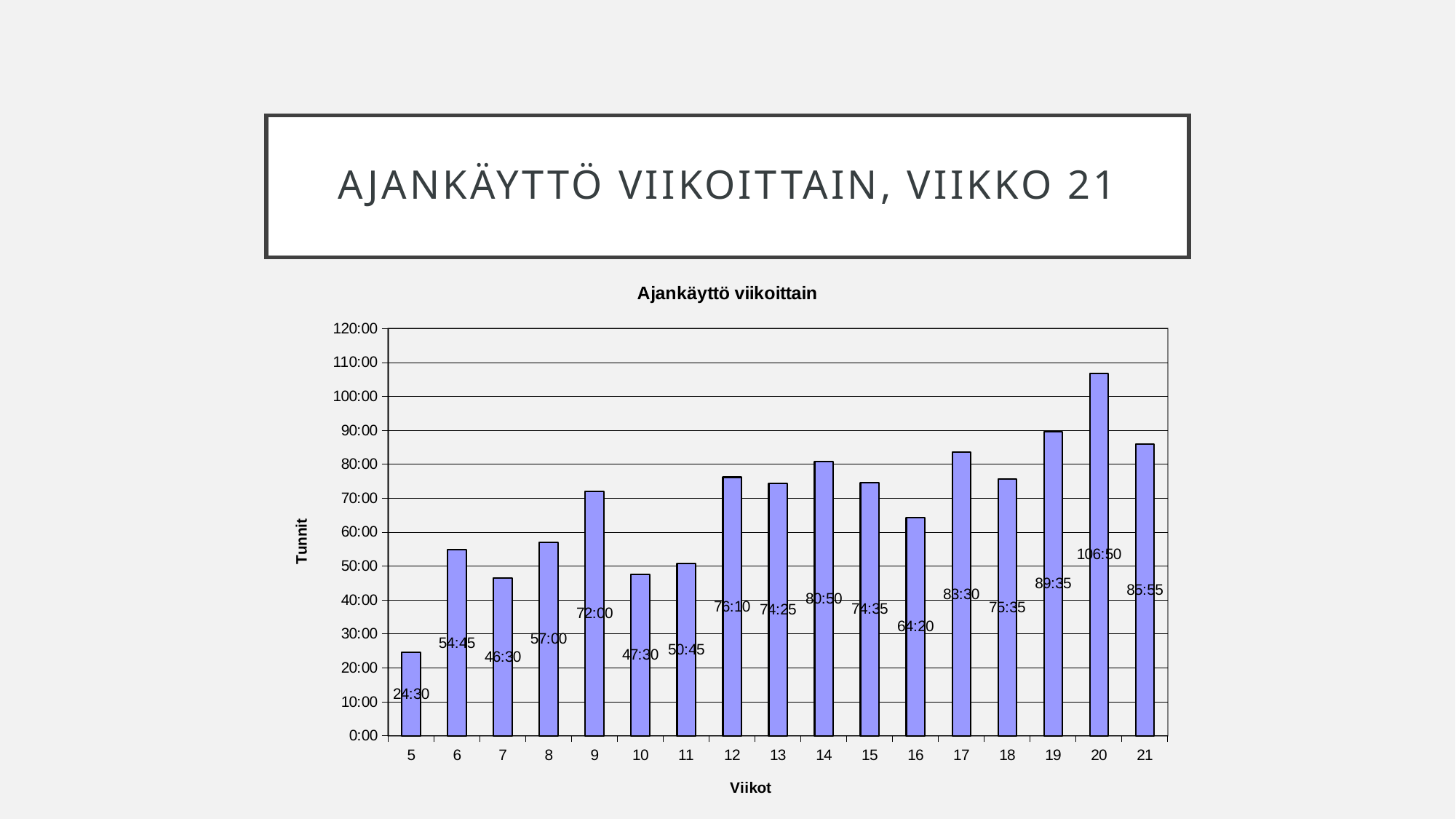
What is the difference between the values for week 20 and week 19? 17:15 Which is larger, the value for week 12 or the value for week 13? week 12 What is the difference between the values for week 9 and week 8? 15:00 Which week has the highest value? 20 Is the value for week 17 greater or less than 80:00? greater What kind of chart is this? bar chart What is the value for week 16? 64:20 What is the label of the y axis? Tunnit Which week has the lowest value? 5 What is the value for week 20? 106:50 What is the value for week 9? 72:00 How many weeks are shown on the x axis? 17